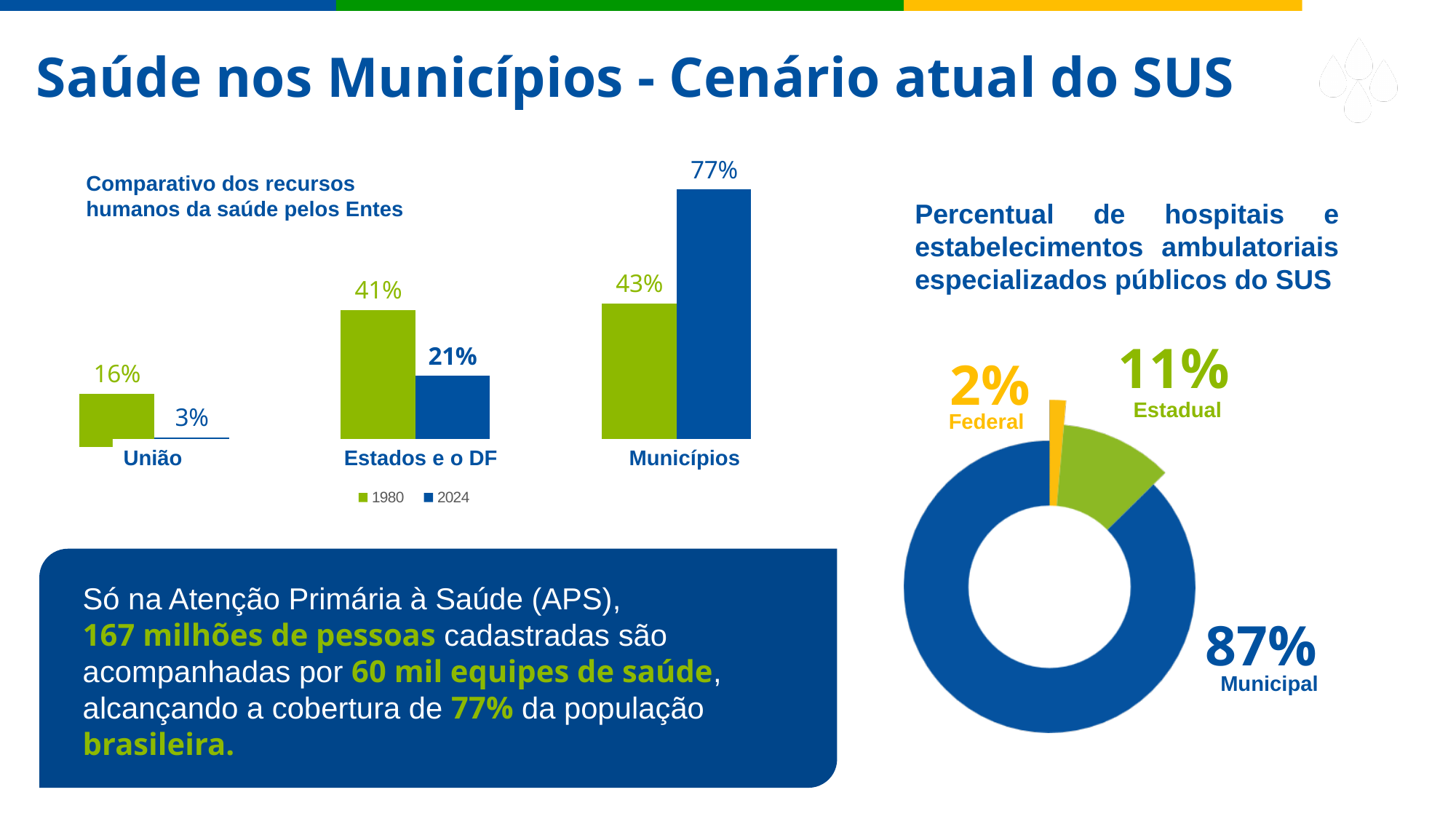
In the bar chart 'Comparativo dos recursos humanos da saúde pelos Entes', is the 1980 value or the 2024 value larger for Estados e o DF? 1980 In the bar chart 'Comparativo dos recursos humanos da saúde pelos Entes', what is the 1980 value for União? 16% In the bar chart 'Comparativo dos recursos humanos da saúde pelos Entes', what is the 2024 value for Estados e o DF? 21% How many series does the legend of the bar chart 'Comparativo dos recursos humanos da saúde pelos Entes' list? 2 In the donut chart 'Percentual de hospitais e estabelecimentos ambulatoriais especializados públicos do SUS', what share is Municipal? 87% In the bar chart 'Comparativo dos recursos humanos da saúde pelos Entes', what is the 2024 value for Municípios? 77% In the bar chart 'Comparativo dos recursos humanos da saúde pelos Entes', which category has the highest 1980 value? Municípios In the donut chart 'Percentual de hospitais e estabelecimentos ambulatoriais especializados públicos do SUS', which slice is the smallest? Federal What kind of chart is the chart on the right of the slide, 'Percentual de hospitais e estabelecimentos ambulatoriais especializados públicos do SUS'? Donut (pie) chart How many categories are shown in the bar chart 'Comparativo dos recursos humanos da saúde pelos Entes'? 3 In the bar chart 'Comparativo dos recursos humanos da saúde pelos Entes', what is the difference between the 2024 and 1980 values for Municípios? 34% In the bar chart 'Comparativo dos recursos humanos da saúde pelos Entes', which category has the lowest 2024 value? União